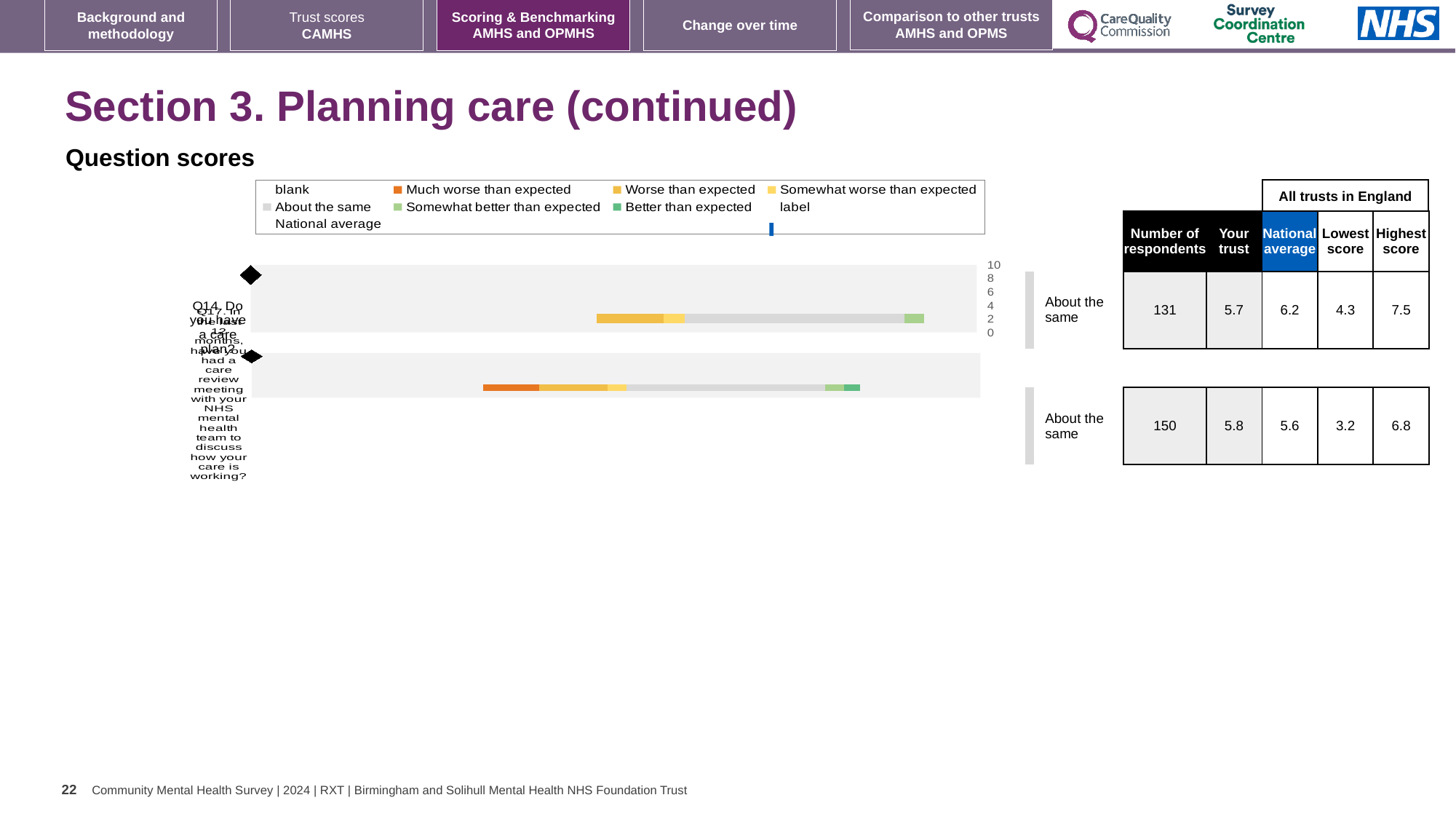
What is the national average score for Q14? 6.2 What is the 'Your trust' score for Q14 (Do you have a care plan?)? 5.7 How many respondents answered Q17 (care review meeting in the last 12 months)? 150 What kind of chart is shown under 'Question scores'? Bar chart What is the highest score among all trusts in England for Q17? 6.8 For Q14, which is larger: the 'Your trust' score or the national average? National average What is the difference between the national average and the 'Your trust' score for Q14? 0.5 How many questions (bars) are plotted in the Question scores chart? 2 In the legend, what colour represents 'Much worse than expected'? Orange Which question had more respondents, Q14 or Q17? Q17 What is the difference between the highest score and the lowest score for Q17? 3.6 What benchmark category is shown for Q14? About the same